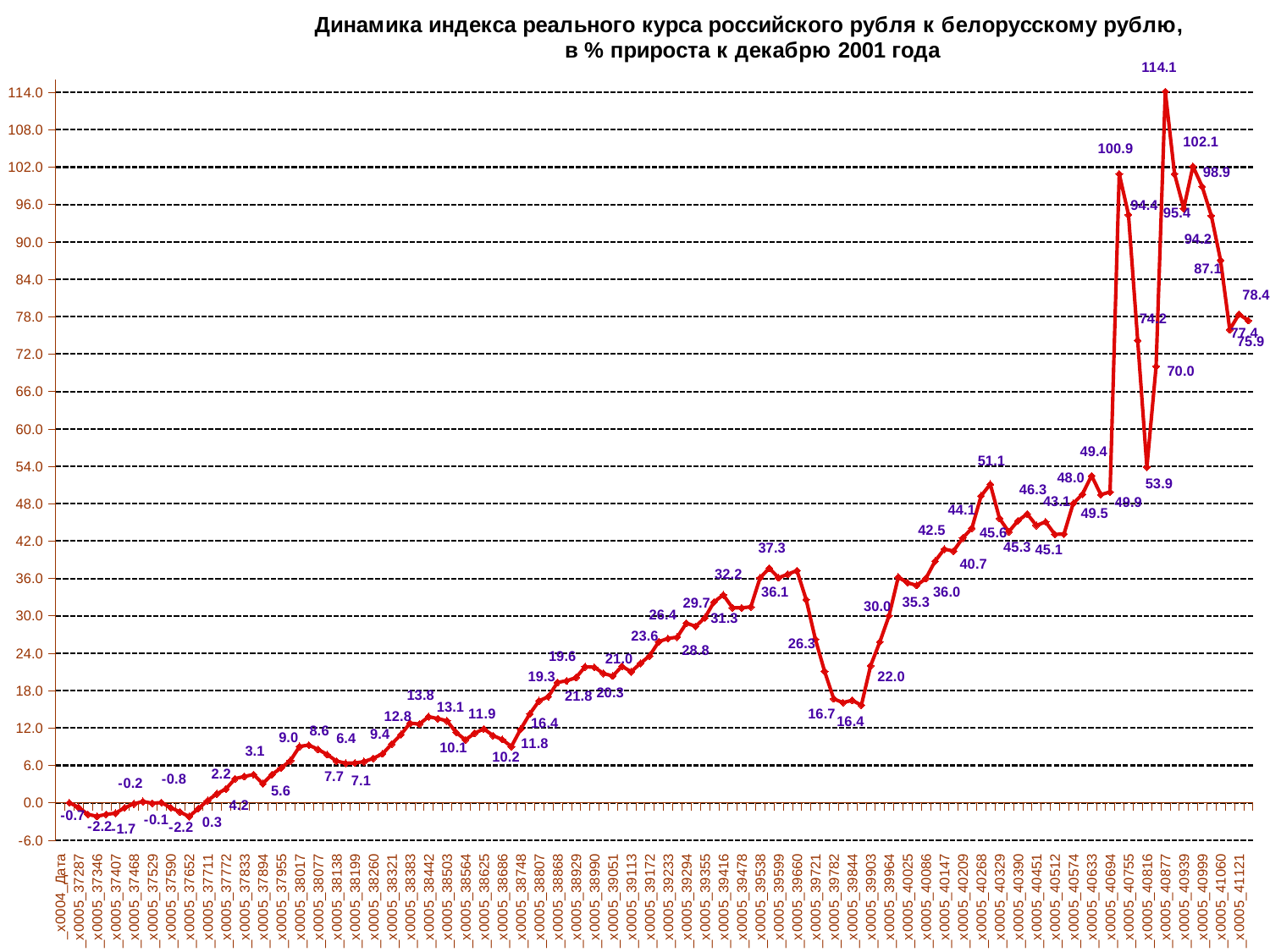
What is the value of the last (rightmost) data point on the chart? 77.4 Do the values generally rise or fall from left to right along the x axis? rise What colour is the plotted line? red What kind of chart is shown on the slide? line chart Is the highest point on the chart greater or less than 108.0? greater What is the title of the chart? Динамика индекса реального курса российского рубля к белорусскому рублю, в % прироста к декабрю 2001 года What is the value of the first (leftmost) data point on the chart? 0.0 What is the difference between the highest labeled value (114.1) and the lowest labeled value (-2.2)? 116.3 What is the lowest value labeled on the chart? -2.2 What is the highest value labeled on the chart? 114.1 Which is larger, the value of the first data point or the value of the last data point? the last data point